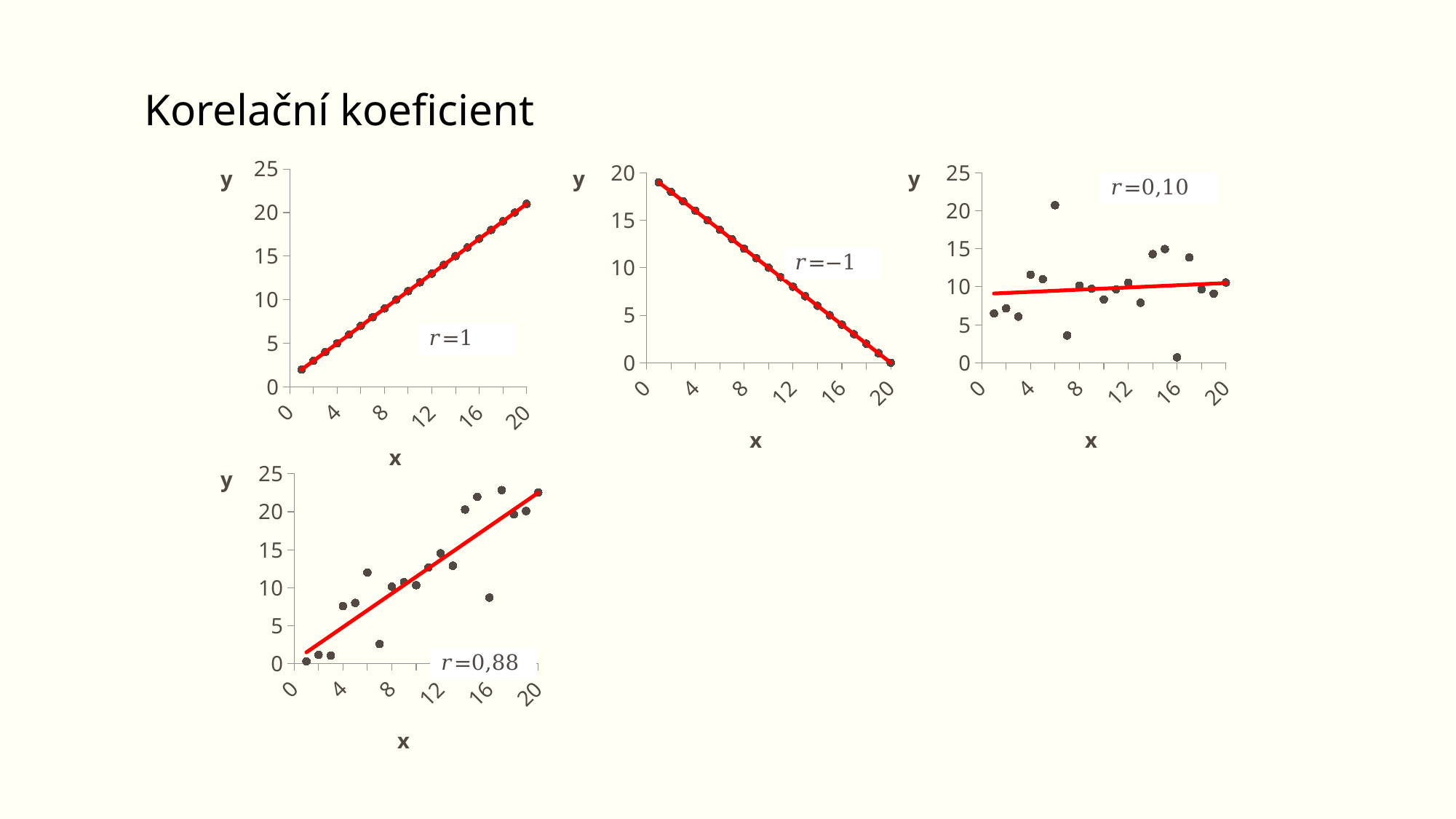
In the top-left chart (r=1), do the y values rise or fall as x increases? rise In the top-right chart (r=0,10), is the y value at x=6 greater or less than 15? greater In the top-middle chart (r=−1), do the y values rise or fall as x increases? fall What correlation coefficient is shown on the top-right chart? r=0,10 In the bottom-left chart (r=0,88), do the y values generally rise or fall as x increases? rise In the bottom-left chart (r=0,88), is the y value at x=16 greater or less than 15? less What correlation coefficient is shown on the bottom-left chart? r=0,88 In the top-right chart (r=0,10), is the y value at x=16 greater or less than 5? less What kind of chart is the top-left chart (r=1)? scatter chart In the top-middle chart (r=−1), which has the larger y value: the point at x=4 or the point at x=16? x=4